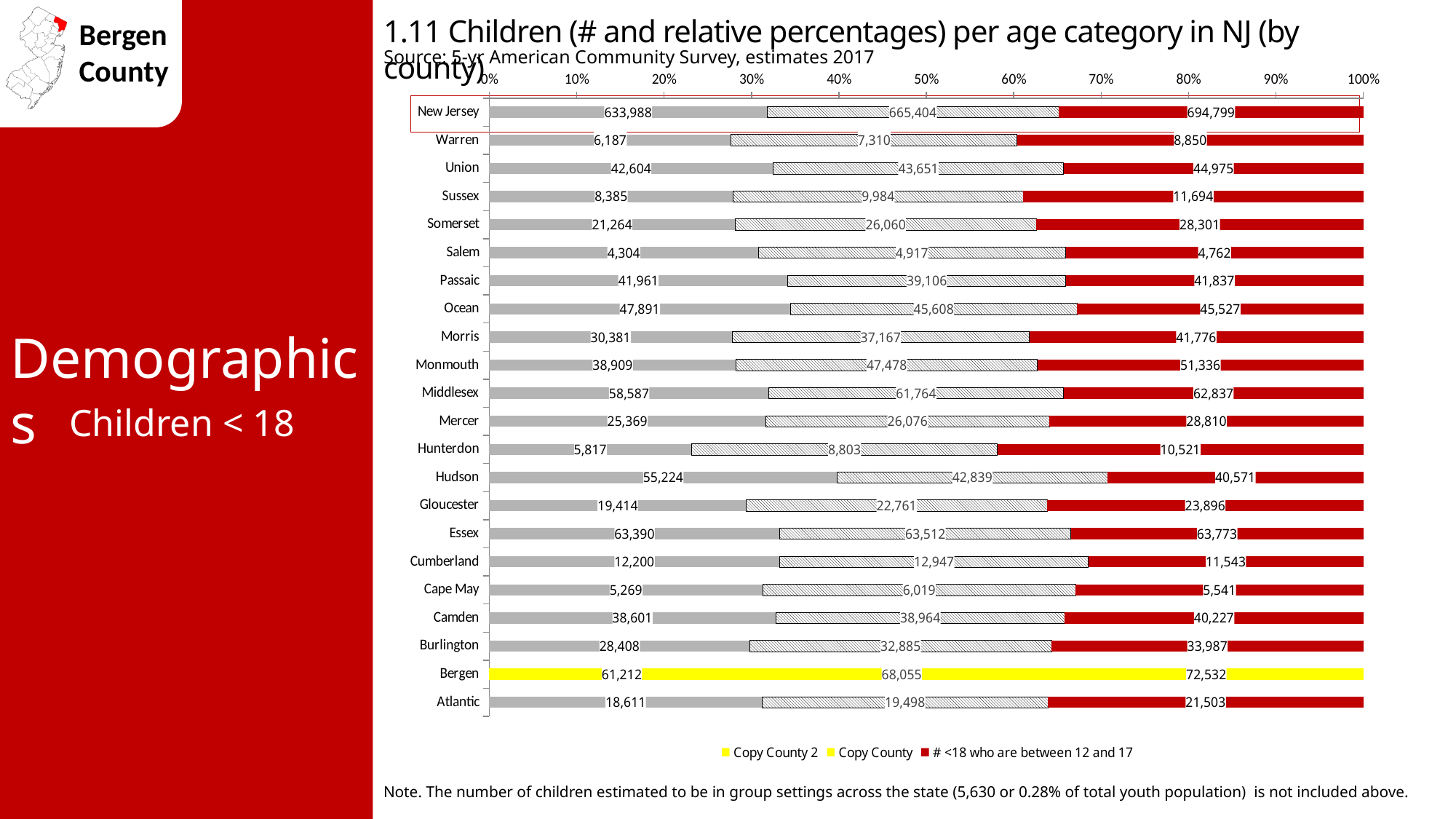
What is the value of the '# <18 who are between 12 and 17' segment for Bergen? 72,532 Excluding the New Jersey total row, which county has the lowest value for '# <18 who are between 12 and 17'? Salem What is the value of the '# <18 who are between 12 and 17' segment for Essex? 63,773 What is the value of the first (leftmost) segment for New Jersey? 633,988 What is the total of the three segments for Bergen? 201,799 How many categories (rows) are plotted on the chart? 22 For Hudson, which is larger: the first segment (55,224) or the '# <18 who are between 12 and 17' segment (40,571)? The first segment (55,224) How many series does the legend list? 3 What is the difference between the '# <18 who are between 12 and 17' value and the first segment value for New Jersey? 60,811 Excluding the New Jersey total row, which county has the highest value for '# <18 who are between 12 and 17'? Bergen Which county's bar is highlighted in yellow on the chart? Bergen What kind of chart is shown on the slide? Stacked bar chart